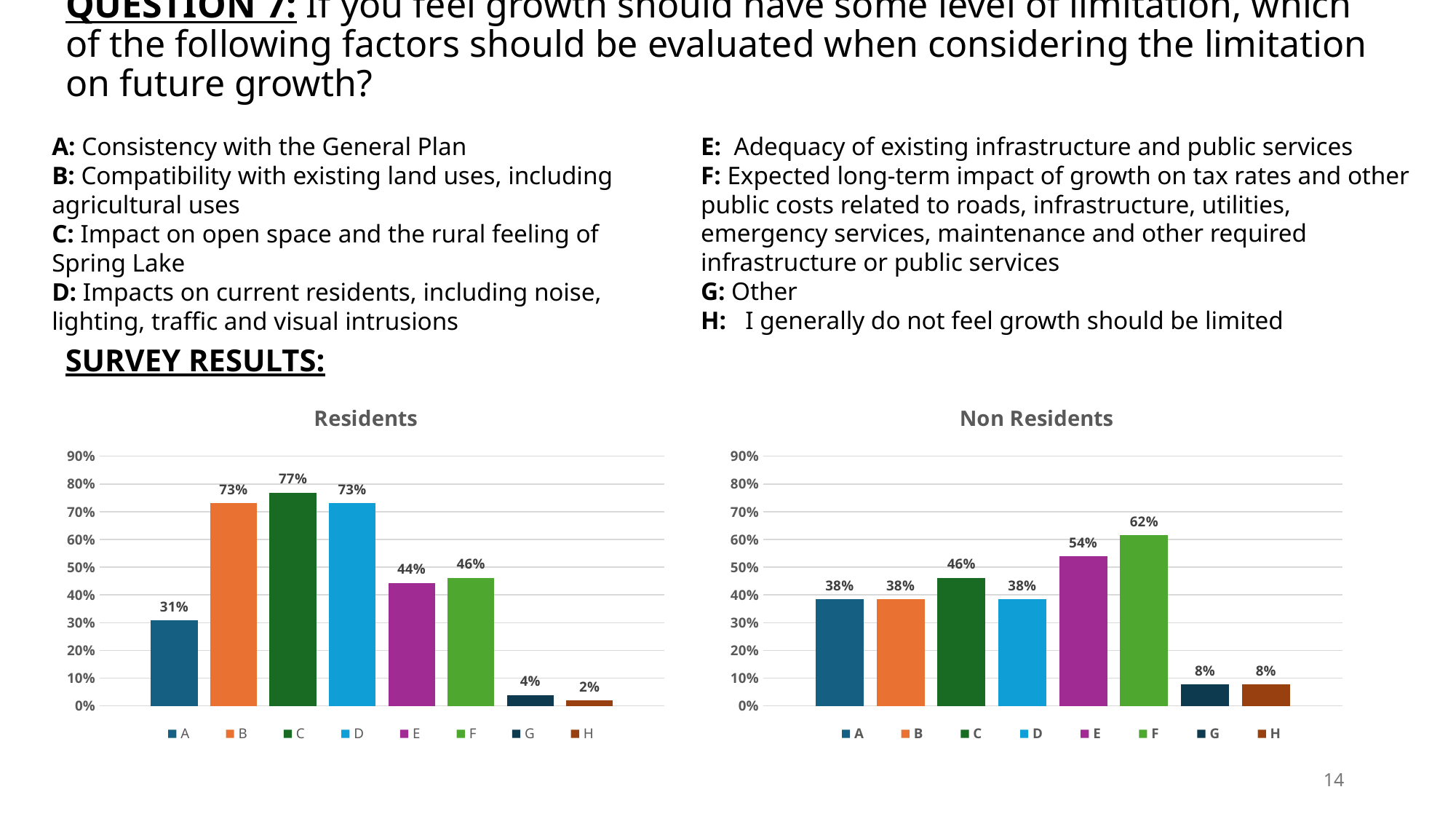
In the Residents chart, which category has the lowest value? H In the Residents chart, which is larger, the value for E or the value for F? F In the Non Residents chart, is the value for E greater or less than 50%? greater In the Non Residents chart, what is the value for F? 62% In the Residents chart, which category has the highest value? C What kind of chart is the Non Residents chart? Bar chart In the Residents chart, what is the difference between the values for C and A? 46% In the Non Residents chart, what is the value for G? 8% In the Residents chart, what is the value for C? 77% How many categories are shown in the Residents chart? 8 In the Non Residents chart, what is the difference between the values for F and E? 8% In the Non Residents chart, which category has the highest value? F